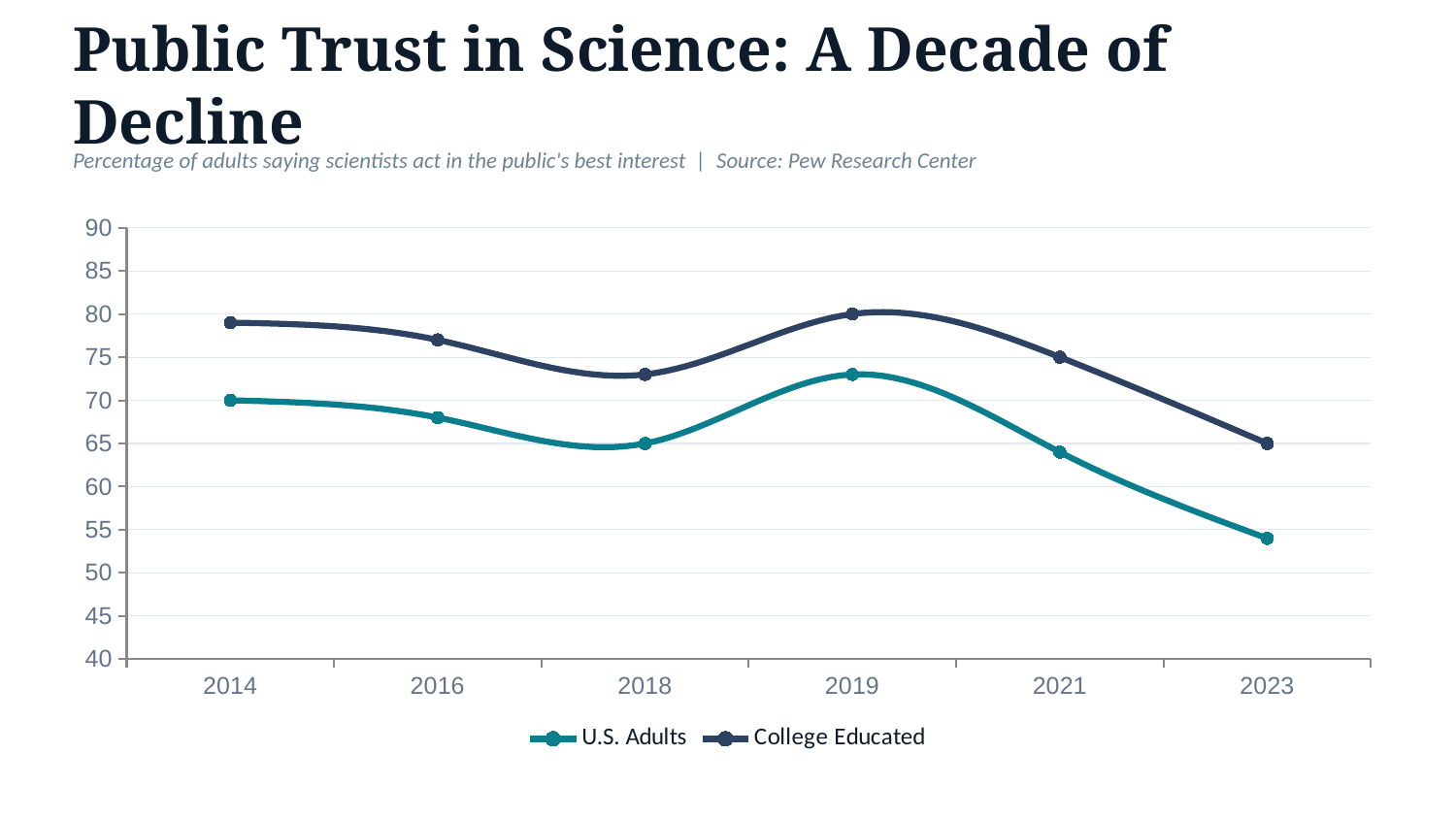
Overall, do the values for U.S. Adults rise or fall from 2014 to 2023? fall What is the value for College Educated in 2023? 65 What type of chart is shown on the slide? Line chart Which series has the higher value in 2023, U.S. Adults or College Educated? College Educated In which year is the U.S. Adults series at its lowest? 2023 What is the value for U.S. Adults in 2014? 70 What is the value for College Educated in 2019? 80 How many years are plotted along the x axis? 6 What is the difference between the College Educated values in 2019 and 2023? 15 In which year is the U.S. Adults series at its highest? 2019 How many series does the legend list? 2